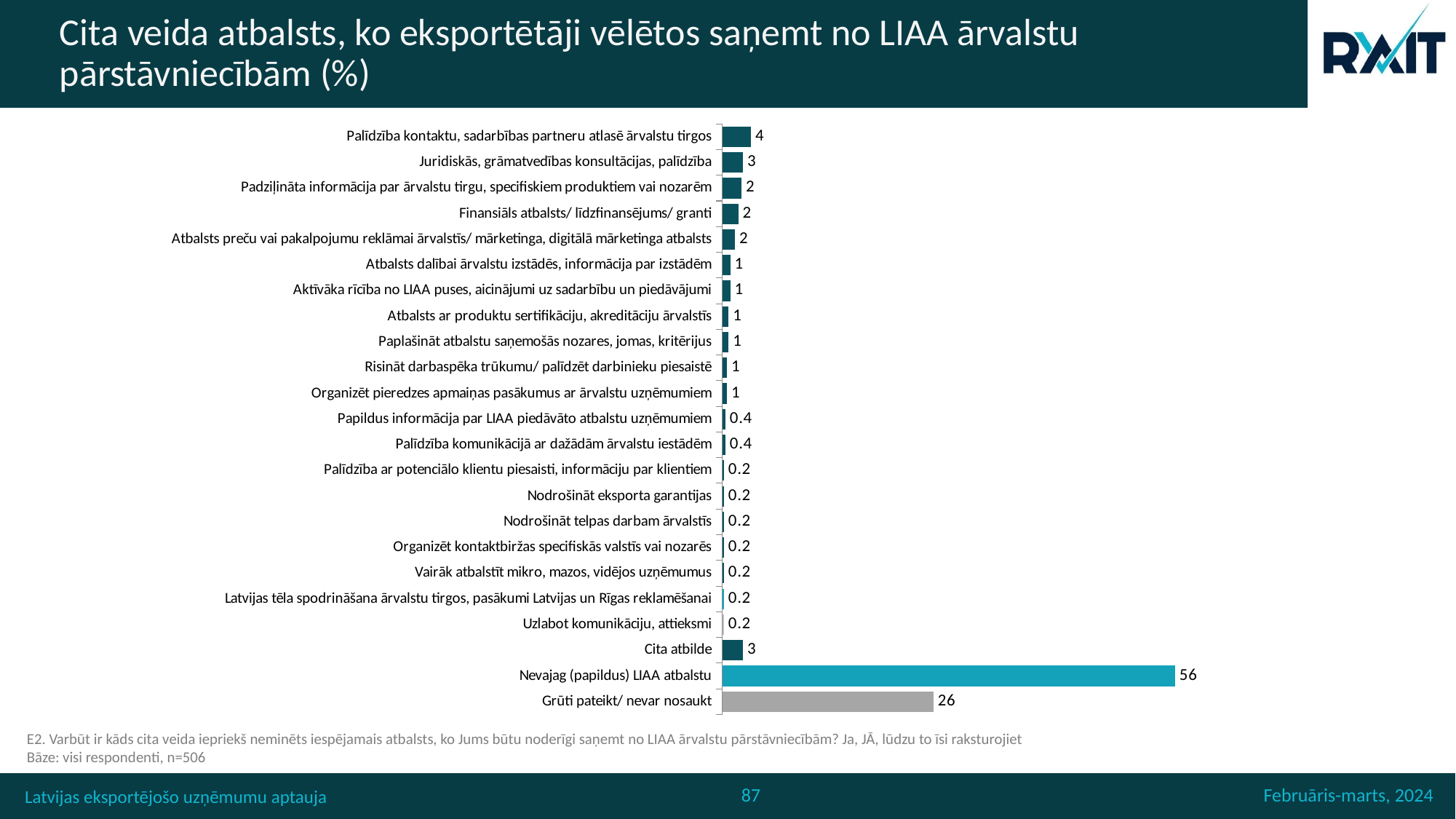
What is the value for "Papildus informācija par LIAA piedāvāto atbalstu uzņēmumiem"? 0.4 Which category has the highest value? Nevajag (papildus) LIAA atbalstu Which is larger: the value for "Juridiskās, grāmatvedības konsultācijas, palīdzība" or the value for "Finansiāls atbalsts/ līdzfinansējums/ granti"? Juridiskās, grāmatvedības konsultācijas, palīdzība What is the value for "Palīdzība kontaktu, sadarbības partneru atlasē ārvalstu tirgos"? 4 What is the value for "Cita atbilde"? 3 What is the base (n) stated below the chart? n=506 How many categories are shown in the chart? 23 What kind of chart is shown on the slide? bar chart What is the difference between the values for "Nevajag (papildus) LIAA atbalstu" and "Grūti pateikt/ nevar nosaukt"? 30 What is the value for "Grūti pateikt/ nevar nosaukt"? 26 What is the difference between the values for "Palīdzība kontaktu, sadarbības partneru atlasē ārvalstu tirgos" and "Atbalsts dalībai ārvalstu izstādēs, informācija par izstādēm"? 3 What is the value for "Nevajag (papildus) LIAA atbalstu"? 56